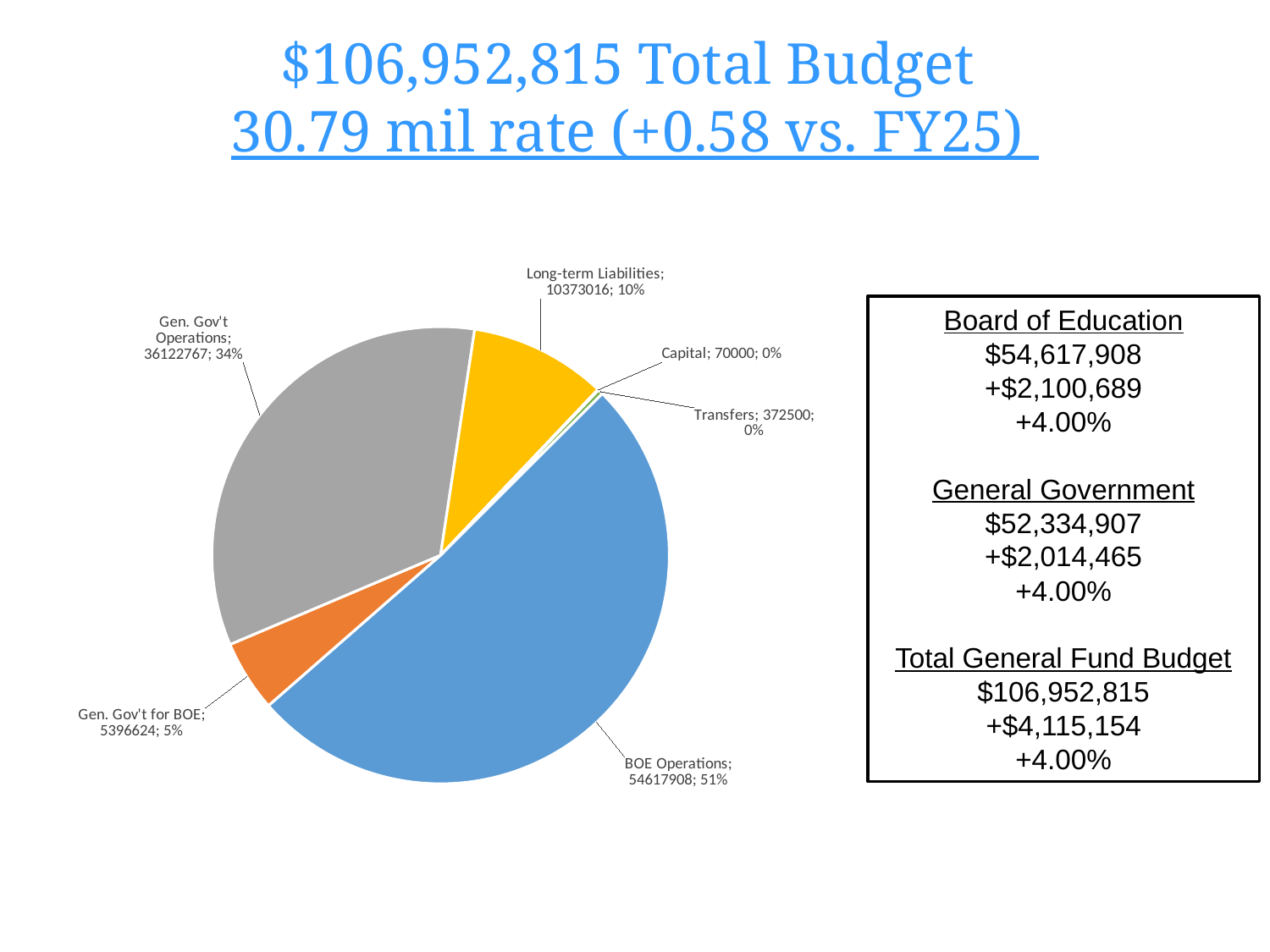
What is the value for Gen. Gov't Operations in the pie chart? 36122767 What is the value for BOE Operations in the pie chart? 54617908 Which slice of the pie chart is the largest? BOE Operations Which slice of the pie chart is the smallest? Capital How many slices does the pie chart have? 6 What is the difference between the values for Transfers and Capital in the pie chart? 302500 What share of the pie does Gen. Gov't Operations represent? 34% Which is larger in the pie chart, Long-term Liabilities or Gen. Gov't for BOE? Long-term Liabilities What is the value for Transfers in the pie chart? 372500 What kind of chart is shown on the slide? pie chart What is the value for Long-term Liabilities in the pie chart? 10373016 What share of the pie does Gen. Gov't for BOE represent? 5%